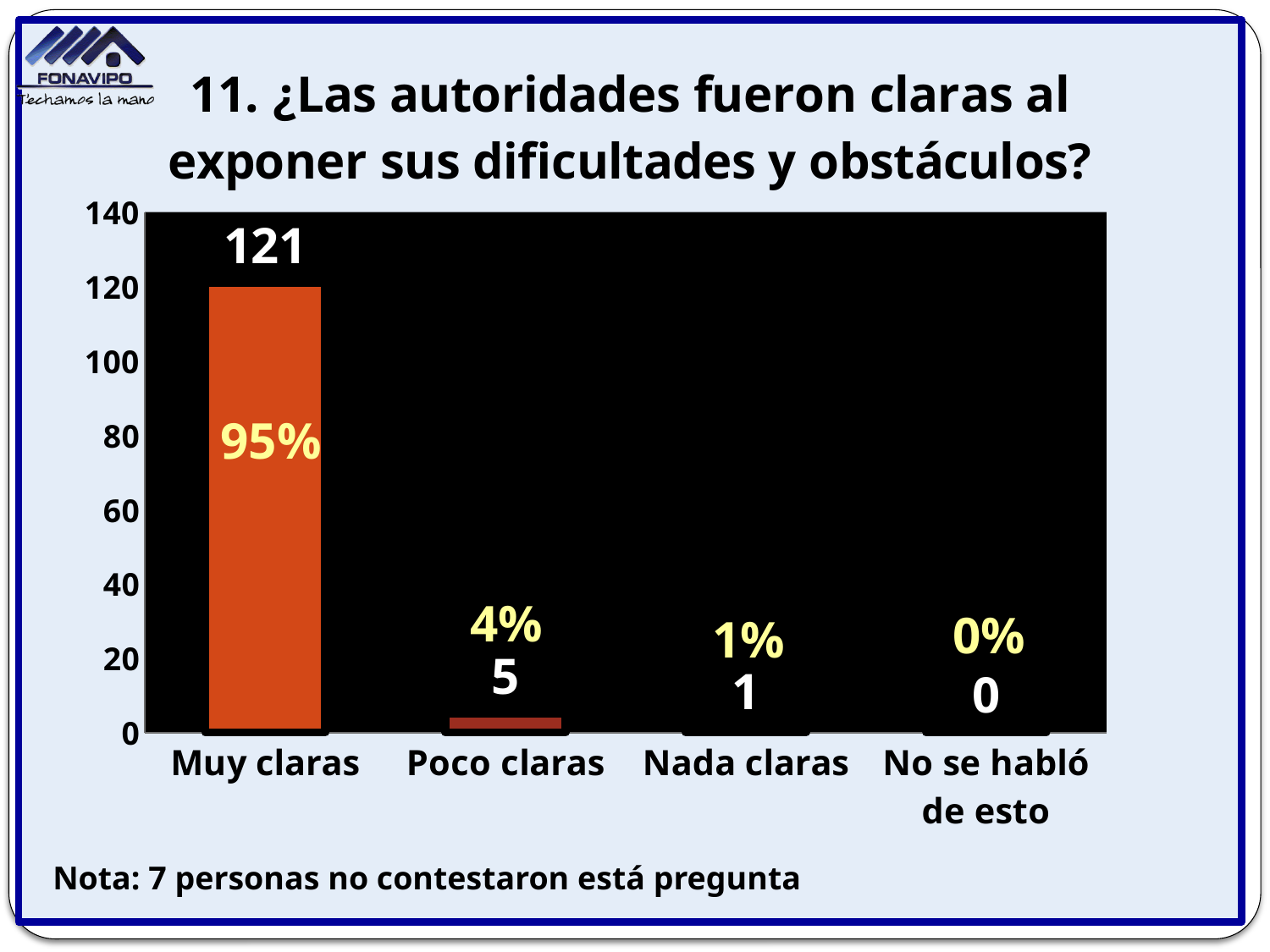
What is the value for "Muy claras"? 121 What is the value for "Poco claras"? 5 What percentage is shown for "Muy claras"? 95% Which category has the highest value? Muy claras What percentage is shown for "No se habló de esto"? 0% What is the value for "Nada claras"? 1 Is the value for "Muy claras" greater or less than 100? greater Which category has the lowest value? No se habló de esto What is the difference between the values for "Muy claras" and "Poco claras"? 116 How many categories are shown on the x axis? 4 Which is larger, the value for "Poco claras" or the value for "Nada claras"? Poco claras What kind of chart is shown on the slide? bar chart